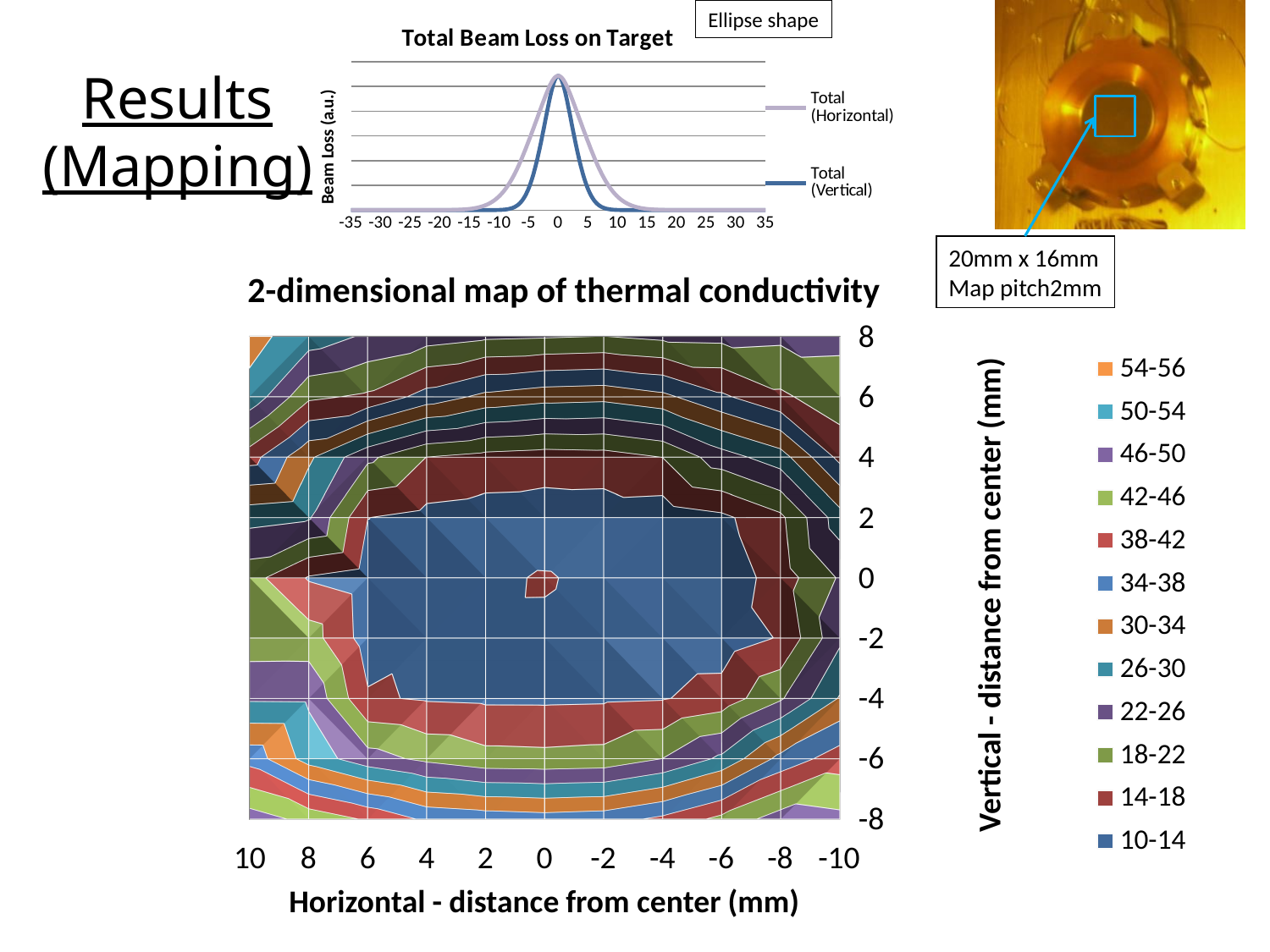
How many tick labels are on the horizontal axis of the '2-dimensional map of thermal conductivity' chart? 11 What is the highest value range shown in the legend of the '2-dimensional map of thermal conductivity' chart? 54-56 How many value ranges does the legend of the '2-dimensional map of thermal conductivity' chart list? 12 What is the y-axis label of the 'Total Beam Loss on Target' chart? Beam Loss (a.u.) What is the title of the lower chart on the slide? 2-dimensional map of thermal conductivity How many series does the legend of the 'Total Beam Loss on Target' chart list? 2 In the 'Total Beam Loss on Target' chart, at which x-axis value do both series reach their peak? 0 What type of chart is the 'Total Beam Loss on Target' chart? Line chart In the 'Total Beam Loss on Target' chart, which series has the wider peak, Total (Horizontal) or Total (Vertical)? Total (Horizontal) In the 'Total Beam Loss on Target' chart, how do the values change as x moves from 0 to 35? They fall What is the lowest value range shown in the legend of the '2-dimensional map of thermal conductivity' chart? 10-14 What is the x-axis title of the '2-dimensional map of thermal conductivity' chart? Horizontal - distance from center (mm)